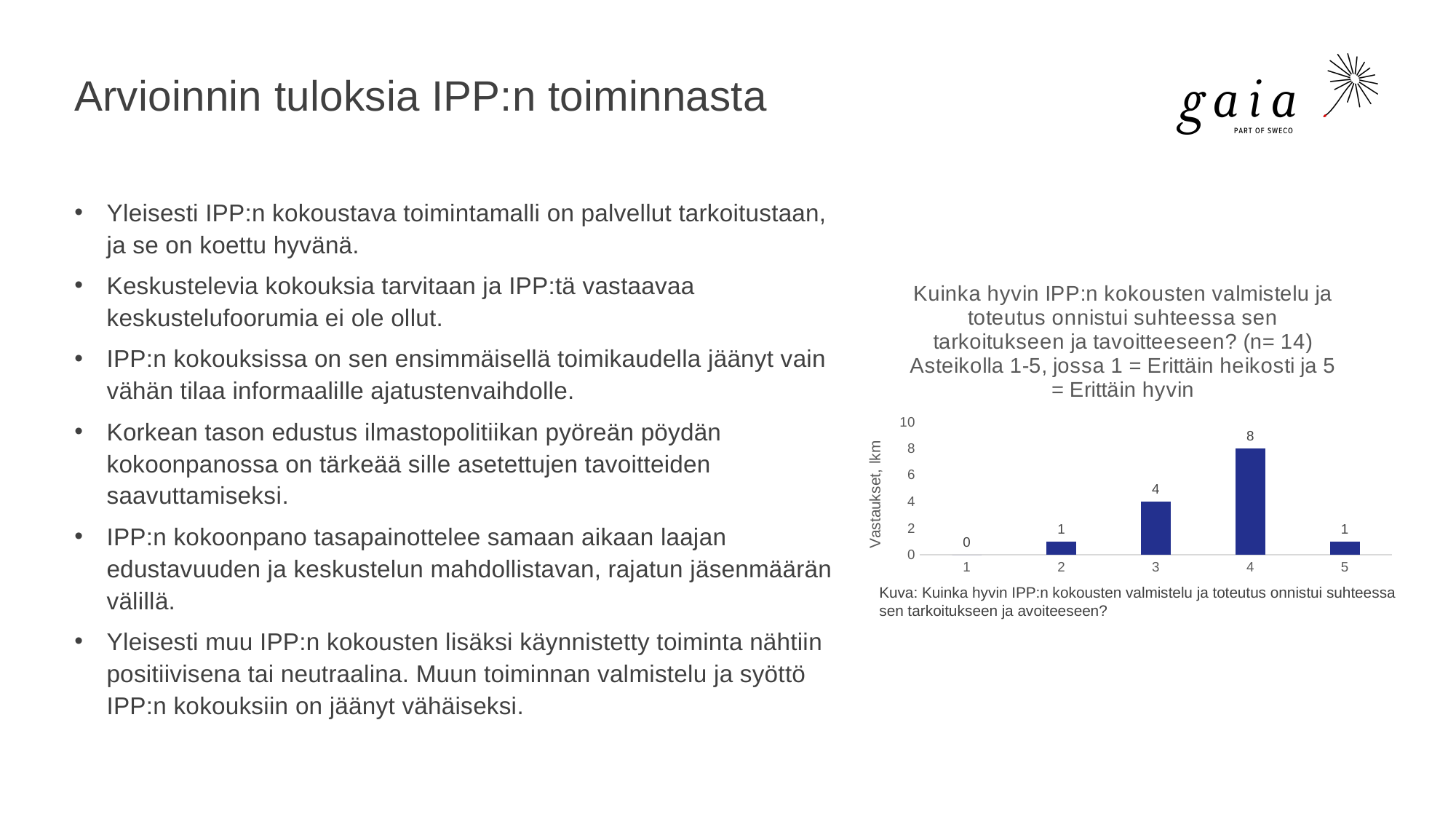
What is the label of the vertical axis of the chart? Vastaukset, lkm Which rating received the fewest responses? 1 What is the difference between the number of responses for rating 4 and rating 3? 4 How many responses are shown for rating 1? 0 According to the chart title, how many respondents (n) answered the question? 14 How many responses are shown for rating 5? 1 What kind of chart is shown on the slide? Bar chart How many rating categories are shown on the x axis? 5 How many responses are shown for rating 4? 8 Which rating received the most responses? 4 How many responses are shown for rating 3? 4 Which has more responses, rating 2 or rating 3? Rating 3